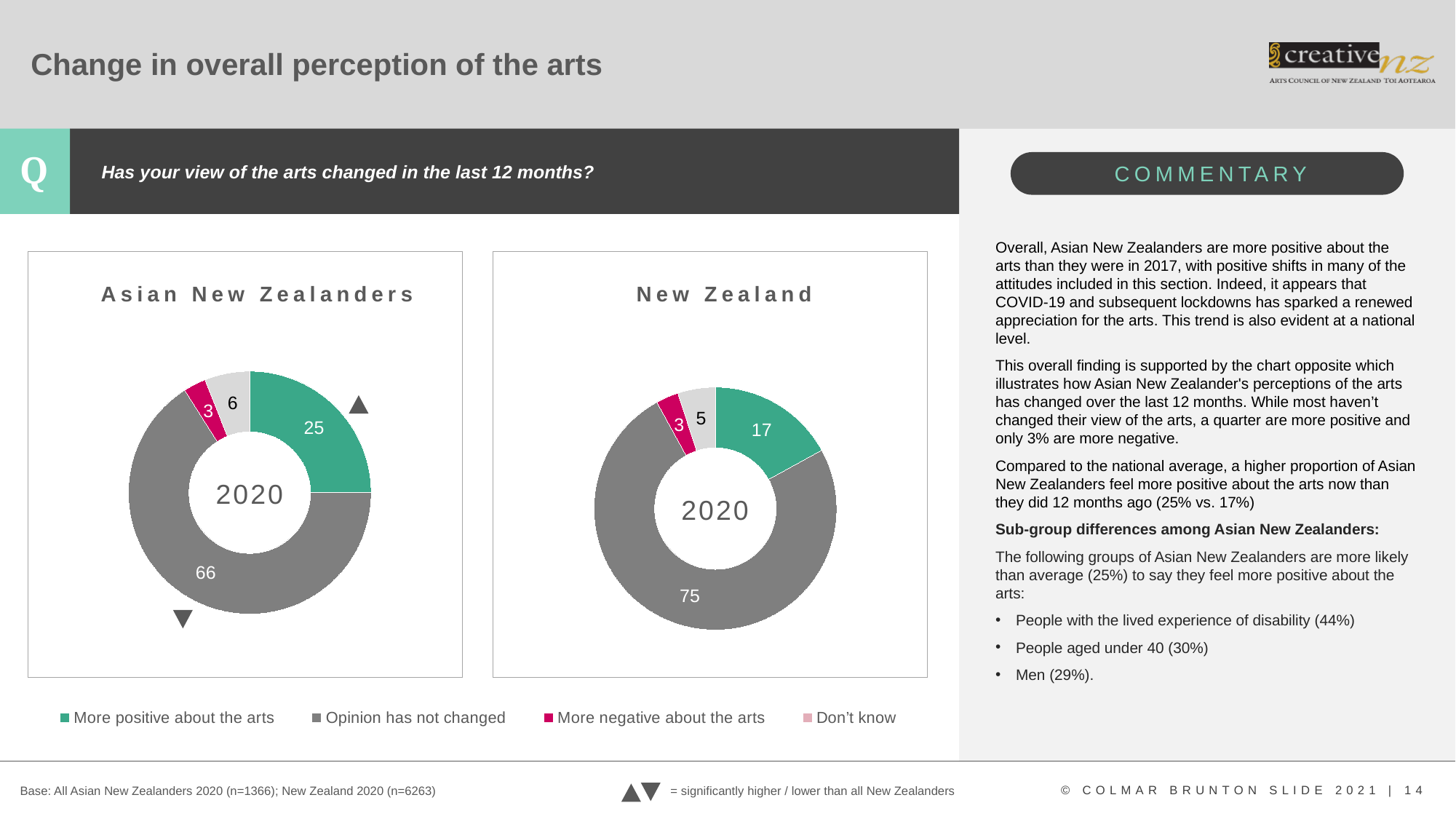
In the Asian New Zealanders chart, which category has the smallest share? More negative about the arts What is the difference between the 'More positive about the arts' values in the Asian New Zealanders chart and the New Zealand chart? 8 In the New Zealand chart, what is the value for 'Opinion has not changed'? 75 In the Asian New Zealanders chart, what is the value for 'More positive about the arts'? 25 In the New Zealand chart, what is the value for 'More negative about the arts'? 3 Which colour represents 'More positive about the arts' in the charts? Green What year is shown in the centre of the New Zealand chart? 2020 What kind of chart is the Asian New Zealanders chart? Donut (pie) chart In the Asian New Zealanders chart, what is the value for 'Don't know'? 6 How many categories does the legend list for the charts? 4 In the New Zealand chart, which category has the largest share? Opinion has not changed Which chart has the larger value for 'Opinion has not changed', Asian New Zealanders or New Zealand? New Zealand